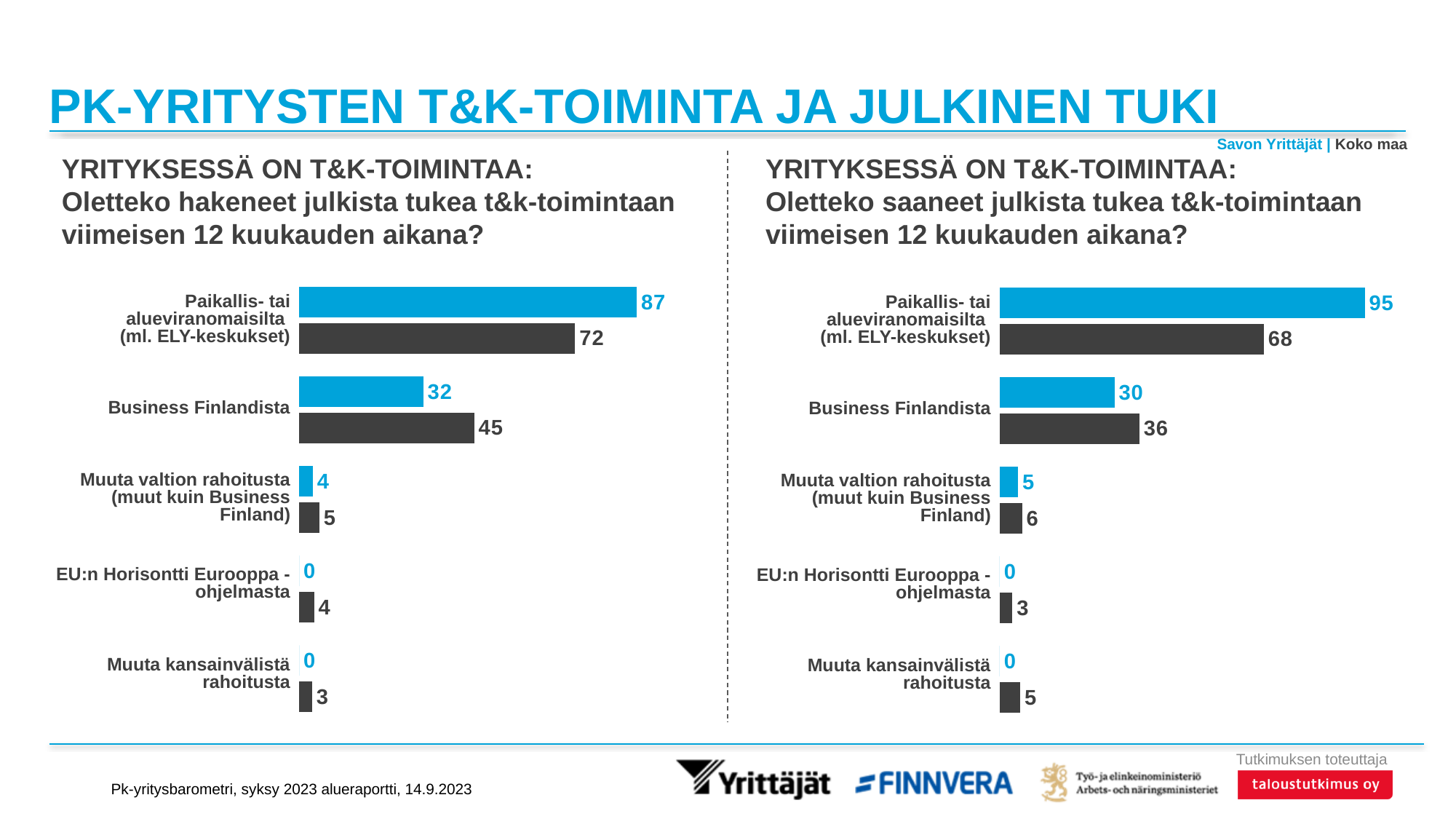
In the left chart (Oletteko hakeneet julkista tukea), what is the difference between the Savon Yrittäjät and Koko maa values for Paikallis- tai alueviranomaisilta? 15 In the left chart (Oletteko hakeneet julkista tukea), what is the Koko maa value for Business Finlandista? 45 In the left chart (Oletteko hakeneet julkista tukea), which is larger for Business Finlandista: the Savon Yrittäjät value or the Koko maa value? Koko maa In the right chart (Oletteko saaneet julkista tukea), what is the Koko maa value for Muuta kansainvälistä rahoitusta? 5 What kind of chart is the left chart (Oletteko hakeneet julkista tukea)? Bar chart In the right chart (Oletteko saaneet julkista tukea), what is the difference between the Koko maa and Savon Yrittäjät values for Business Finlandista? 6 In the right chart (Oletteko saaneet julkista tukea), which category has the lowest Koko maa value? EU:n Horisontti Eurooppa -ohjelmasta How many categories are shown in the right chart (Oletteko saaneet julkista tukea)? 5 In the left chart (Oletteko hakeneet julkista tukea), what is the Savon Yrittäjät value for Paikallis- tai alueviranomaisilta (ml. ELY-keskukset)? 87 In the left chart (Oletteko hakeneet julkista tukea), which category has the highest Savon Yrittäjät value? Paikallis- tai alueviranomaisilta (ml. ELY-keskukset) In the right chart (Oletteko saaneet julkista tukea), what is the Savon Yrittäjät value for Paikallis- tai alueviranomaisilta (ml. ELY-keskukset)? 95 How many series does the legend list for the charts on this slide? 2